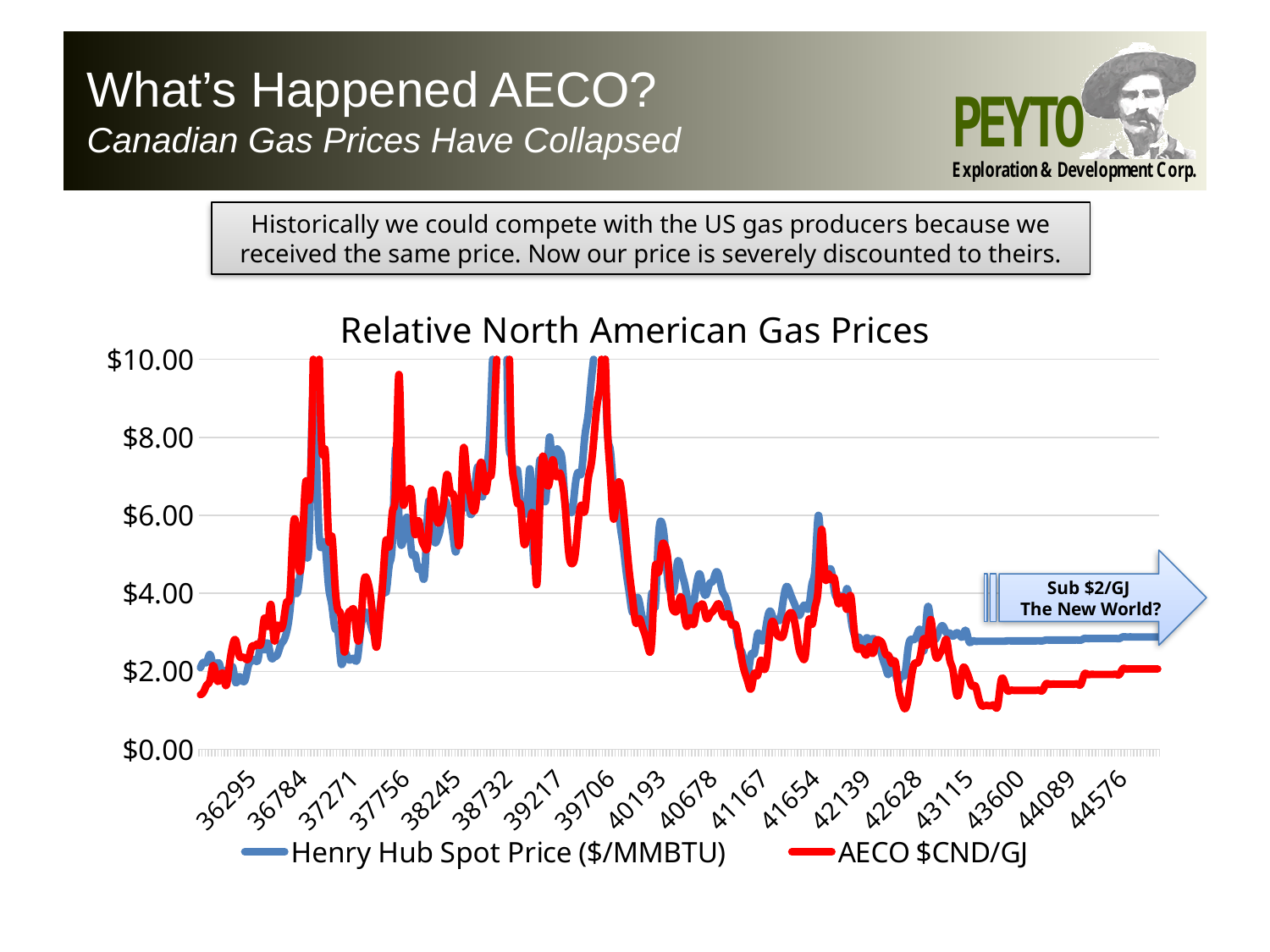
What kind of chart is shown on the slide? line chart Is the value of the Henry Hub Spot Price ($/MMBTU) series at the far right of the chart (around 44576) greater or less than $4.00? less Which series is drawn in red? AECO $CND/GJ How many series does the chart's legend list? 2 What is the highest value shown on the chart's vertical axis? $10.00 Is the value of the AECO $CND/GJ series around the x-axis label 43600 greater or less than $2.00? less At the far right of the chart (around 44576), which series has the higher value, Henry Hub Spot Price ($/MMBTU) or AECO $CND/GJ? Henry Hub Spot Price ($/MMBTU) Is the highest value reached by the AECO $CND/GJ series greater or less than $8.00? greater What is the title of the chart? Relative North American Gas Prices Do the gas prices generally rise or fall from the middle of the chart (around 39706) to the right end of the chart? fall